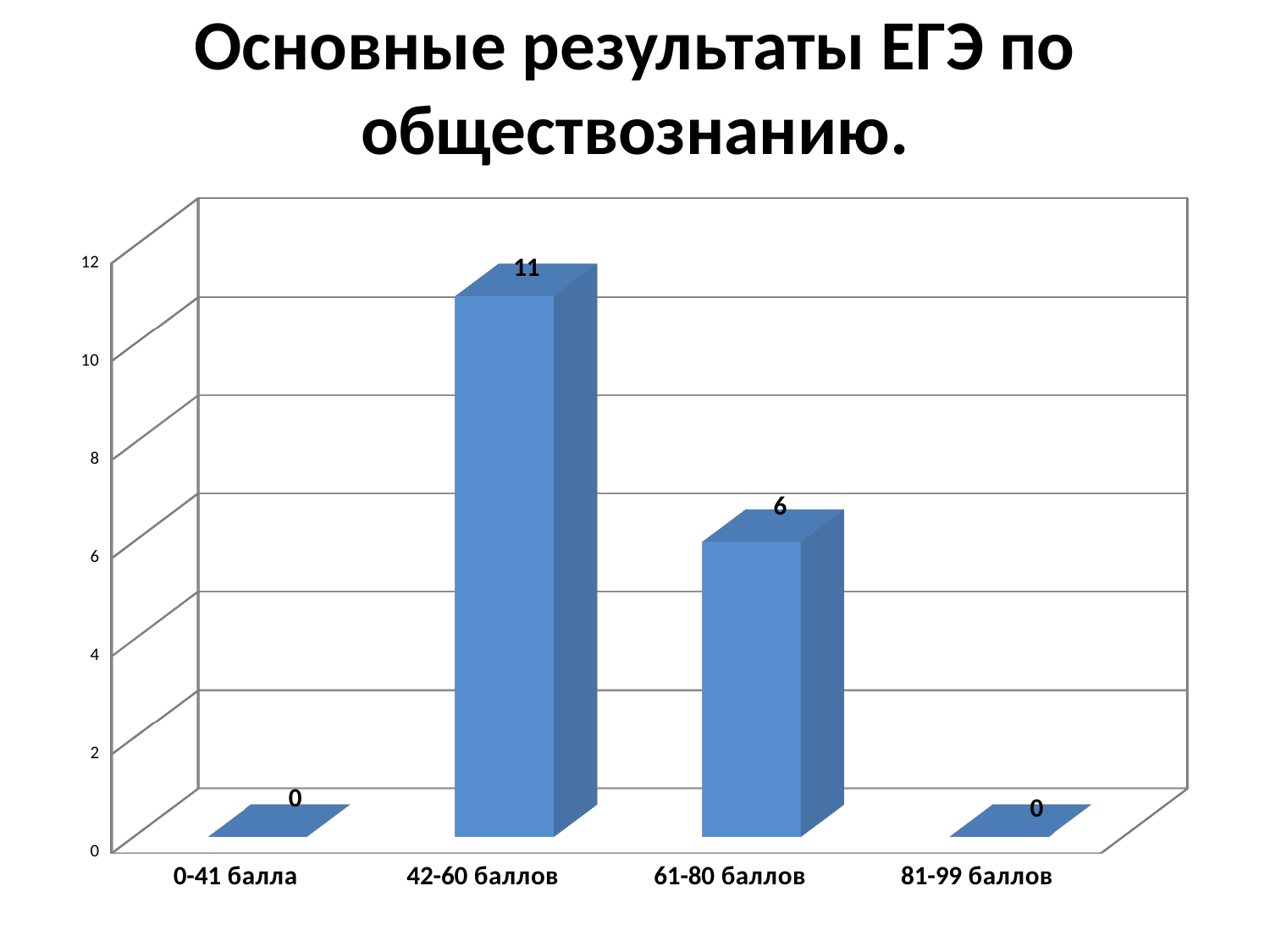
What is the value for the 81-99 баллов category? 0 What is the value for the 61-80 баллов category? 6 What is the value for the 42-60 баллов category? 11 How many categories are shown on the x axis? 4 Is the value for 42-60 баллов greater or less than 10? greater What is the title of the slide? Основные результаты ЕГЭ по обществознанию. What is the difference between the values for 42-60 баллов and 61-80 баллов? 5 Is the value for 61-80 баллов greater or less than 8? less Which category has the highest value? 42-60 баллов What is the value for the 0-41 балла category? 0 Which is larger, the value for 42-60 баллов or the value for 61-80 баллов? 42-60 баллов What kind of chart is shown on the slide? bar chart